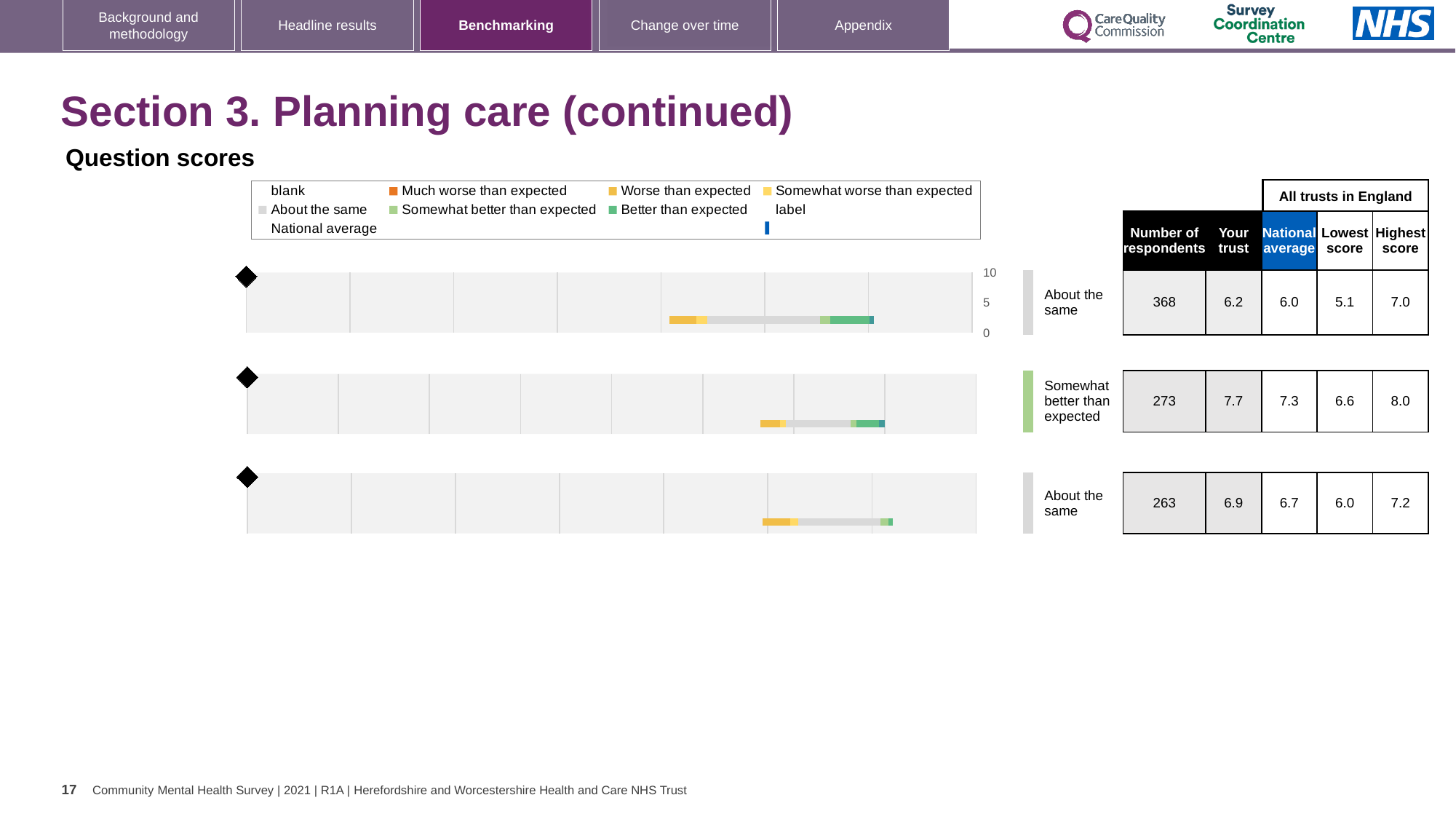
Which benchmark category label is shown next to the middle chart? Somewhat better than expected In the top chart's table row, how many respondents are listed? 368 How many question charts are shown on the slide? 3 For the middle chart, what is the difference between the 'Your trust' score and the national average? 0.4 What kind of chart is used for the question scores on this slide? Bar chart For the top chart, which is larger: the 'Your trust' score or the national average? Your trust Which of the three charts (top, middle or bottom) has the lowest number of respondents? Bottom In the bottom chart's table row, what is the highest score across all trusts in England? 7.2 Which of the three charts (top, middle or bottom) has the highest 'Your trust' score? Middle In the middle chart's table row, what is the national average score? 7.3 For the bottom chart, what is the difference between the highest score and the lowest score across all trusts in England? 1.2 In the top chart's table row, what is the 'Your trust' score? 6.2